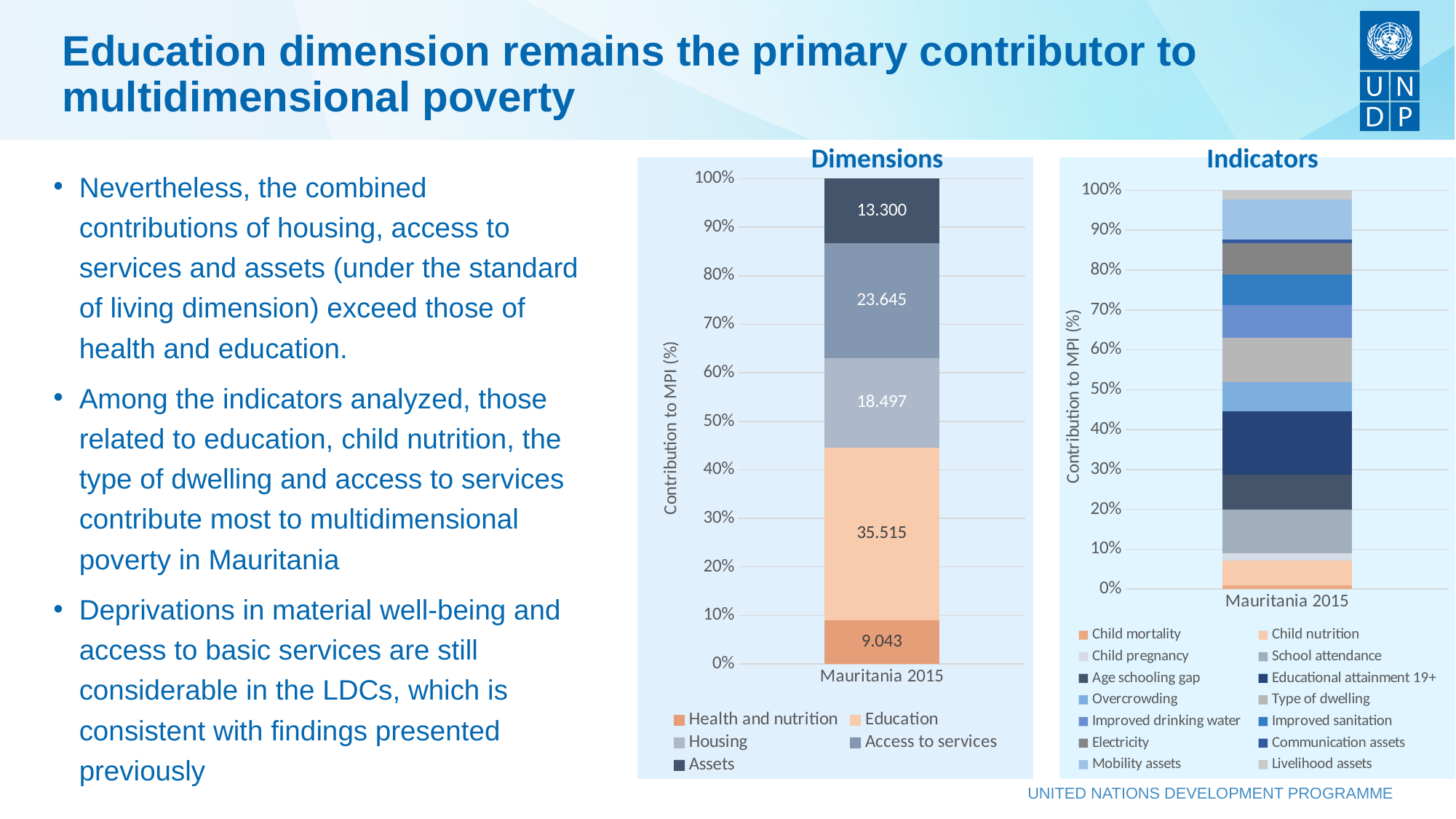
In the Dimensions chart, which is larger, Access to services or Housing? Access to services In the Dimensions chart, what is the value for Health and nutrition? 9.043 In the Dimensions chart, what is the difference between the Education value and the Housing value? 17.018 In the Dimensions chart, what is the value for Education? 35.515 What is the y-axis label of the Dimensions chart? Contribution to MPI (%) In the Dimensions chart, what is the value for Access to services? 23.645 In the Dimensions chart, what is the value for Assets? 13.300 How many series does the legend of the Indicators chart list? 14 What kind of chart is the Indicators chart? Stacked bar chart In the Dimensions chart, which dimension has the smallest contribution to MPI? Health and nutrition In the Dimensions chart, which dimension has the largest contribution to MPI? Education How many series does the legend of the Dimensions chart list? 5